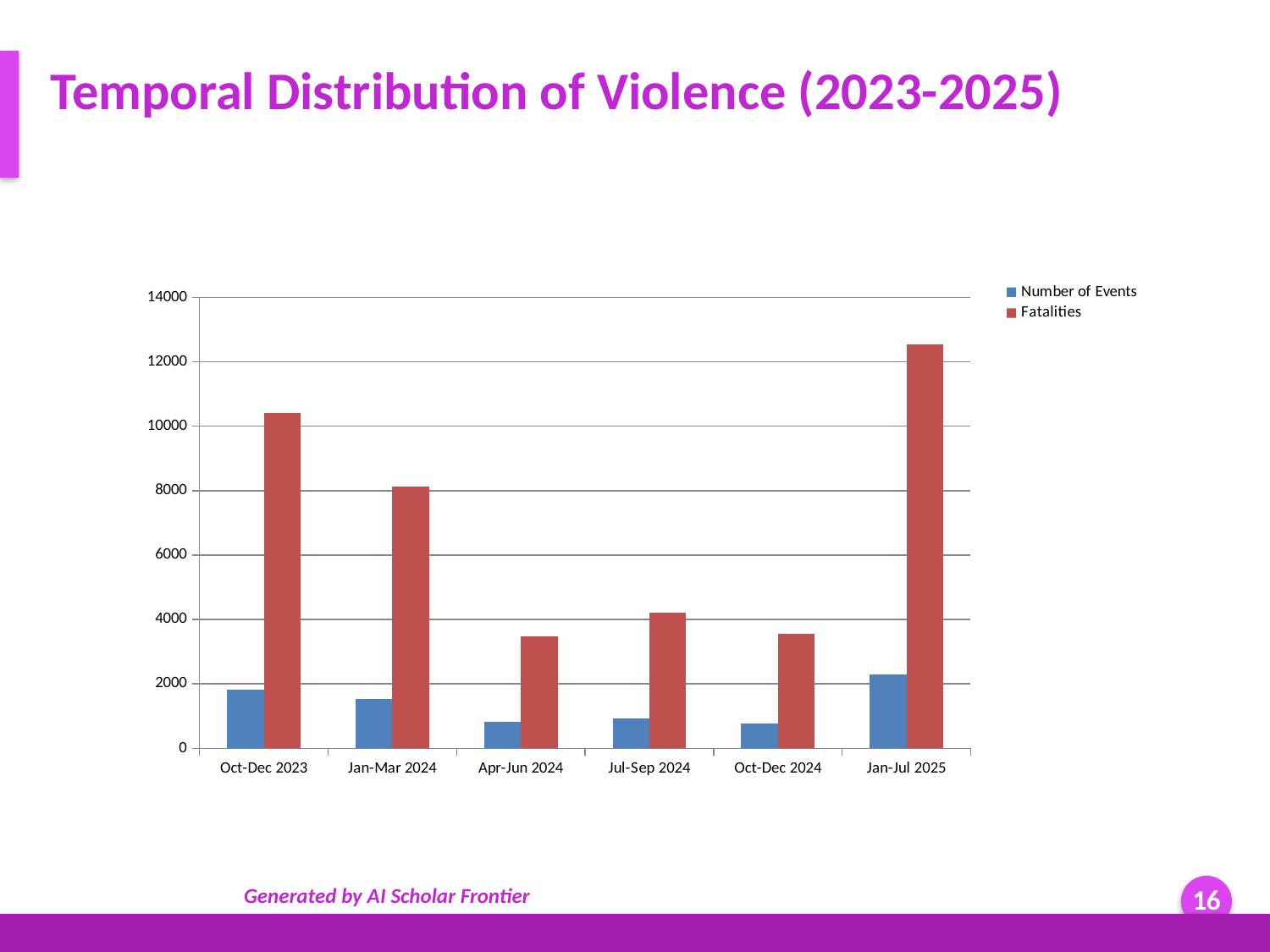
How many time periods are shown on the x axis? 6 How many series does the legend list? 2 Which period has more fatalities, Oct-Dec 2023 or Jan-Mar 2024? Oct-Dec 2023 Which period has more fatalities, Apr-Jun 2024 or Jul-Sep 2024? Jul-Sep 2024 Is the Fatalities value for Apr-Jun 2024 greater or less than 4000? less What kind of chart is shown on the slide? bar chart Is the Fatalities value for Oct-Dec 2023 greater or less than 10000? greater Is the Number of Events value for Jan-Jul 2025 greater or less than 2000? greater Which period has the highest number of fatalities? Jan-Jul 2025 Which period has the highest number of events? Jan-Jul 2025 What colour represents the Fatalities series in the legend? red